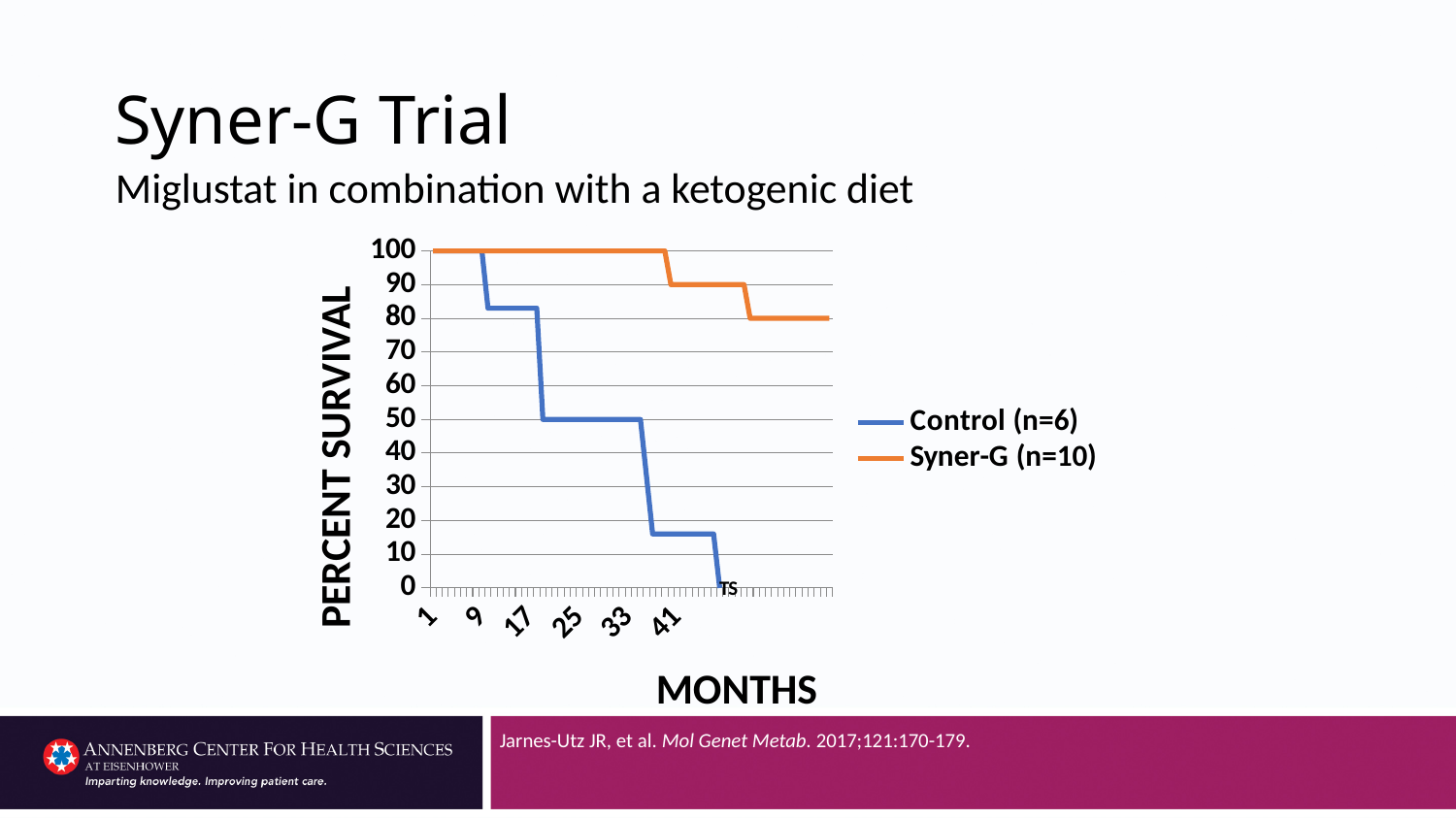
At what percent survival does the Syner-G (n=10) curve end at the right side of the chart? 80 What are the two series named in the legend? Control (n=6) and Syner-G (n=10) Is the percent survival for Syner-G (n=10) at month 25 greater or less than 90? greater How many series does the legend list? 2 At what percent survival do both curves start at month 1? 100 Which series has the higher percent survival at month 33? Syner-G (n=10) What is the title of the vertical axis? PERCENT SURVIVAL What is the lowest percent survival reached by the Control (n=6) curve? 0 Which series reaches 0 percent survival? Control (n=6) What kind of chart is shown on the slide? line chart Is the percent survival for Control (n=6) at month 25 greater or less than 70? less Do the survival values for the Control (n=6) series rise or fall as months increase? fall